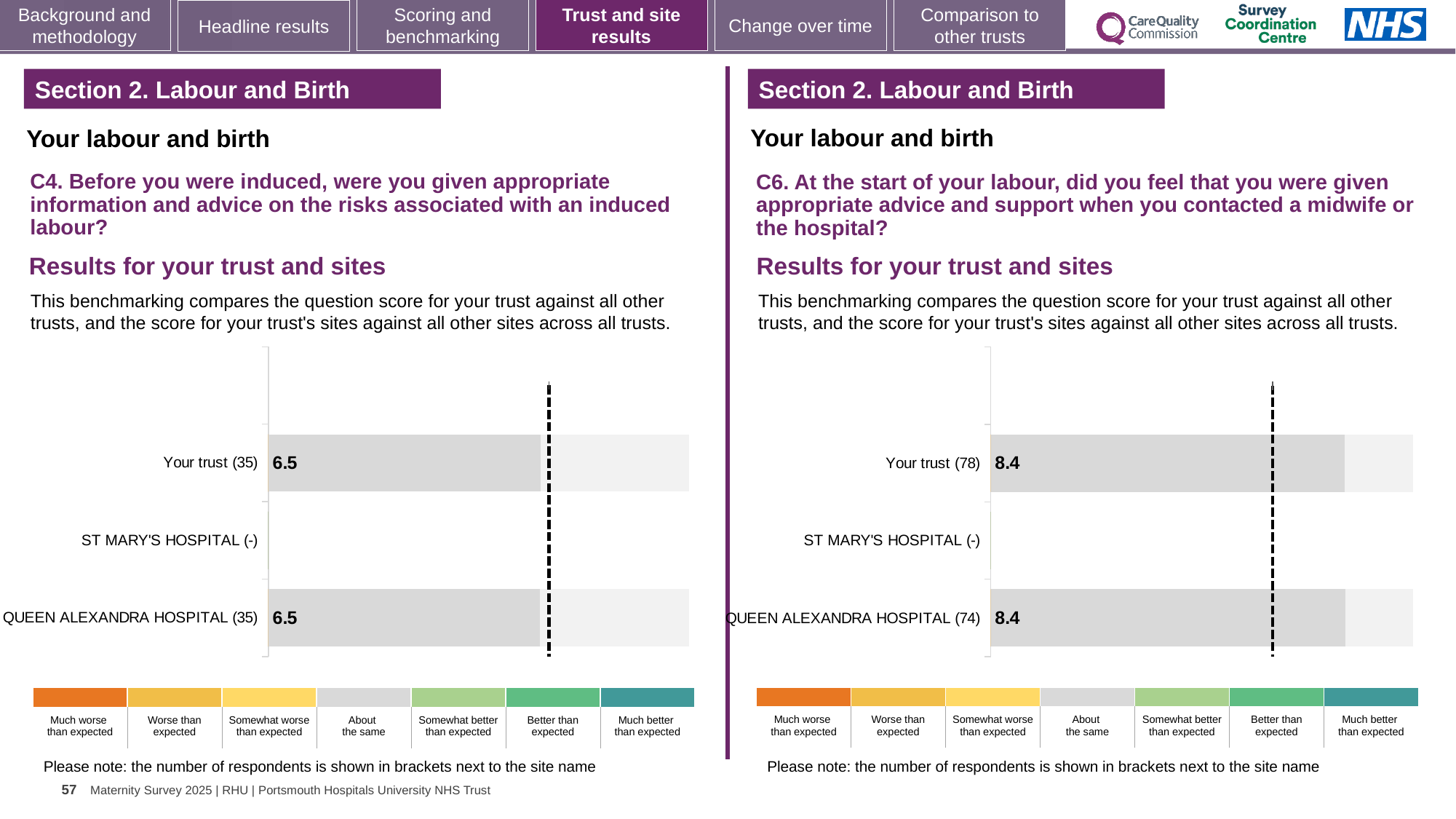
How many site/trust categories are listed on the left chart (C4)? 3 In the right chart (C6), how many respondents are shown in brackets for Your trust? 78 In the left chart (C4), what is the difference between the score for Your trust and the score for QUEEN ALEXANDRA HOSPITAL? 0 In the left chart (C4), what is the score for Your trust? 6.5 In the right chart (C6), what is the score for QUEEN ALEXANDRA HOSPITAL? 8.4 In the left chart (C4), what is the score for QUEEN ALEXANDRA HOSPITAL? 6.5 In the right chart (C6), how many respondents are shown in brackets for QUEEN ALEXANDRA HOSPITAL? 74 Which site on the right chart (C6) has no score shown, indicated by (-)? ST MARY'S HOSPITAL In the left chart (C4), how many respondents are shown in brackets for Your trust? 35 What is the label of the leftmost colour band in the legend below the left chart (C4)? Much worse than expected In the right chart (C6), what is the score for Your trust? 8.4 What type of chart is used on the right side of the slide (C6)? Bar chart